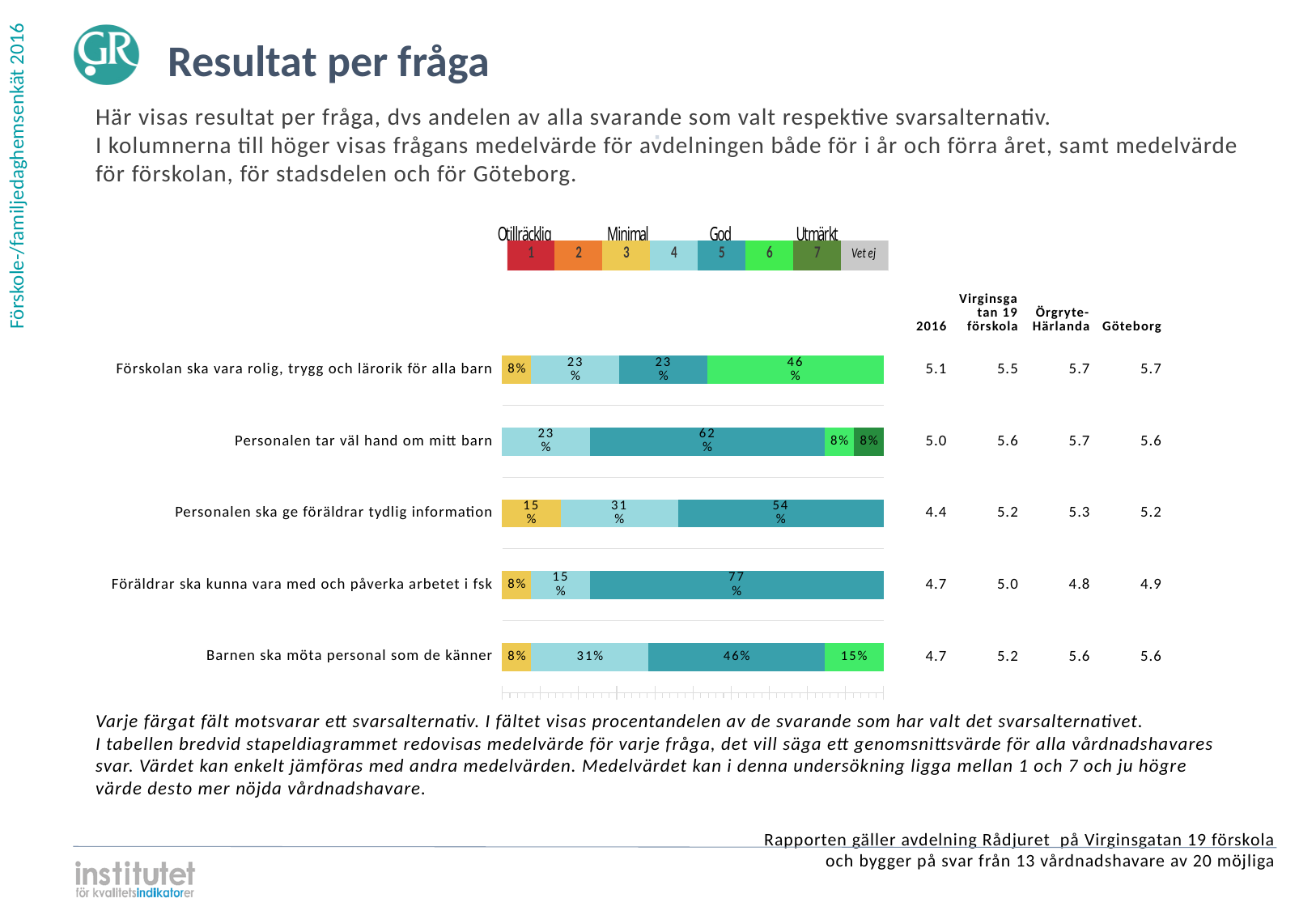
Which question has the largest single segment in the bar chart? Föräldrar ska kunna vara med och påverka arbetet i fsk What percentage of respondents chose alternative 6 (bright green) for 'Förskolan ska vara rolig, trygg och lärorik för alla barn'? 46% Which question is the only one with a segment for alternative 7 (dark green)? Personalen tar väl hand om mitt barn What kind of chart is shown on the slide? Stacked bar chart How many questions (categories) are plotted in the bar chart? 5 What percentage of respondents chose alternative 5 (teal) for 'Föräldrar ska kunna vara med och påverka arbetet i fsk'? 77% What is the difference between the alternative 5 share for 'Föräldrar ska kunna vara med och påverka arbetet i fsk' (77%) and for 'Personalen ska ge föräldrar tydlig information' (54%)? 23% Which is larger: the alternative 6 share for 'Förskolan ska vara rolig, trygg och lärorik för alla barn' or for 'Barnen ska möta personal som de känner'? Förskolan ska vara rolig, trygg och lärorik för alla barn What percentage of respondents chose alternative 4 (light blue) for 'Barnen ska möta personal som de känner'? 31% What percentage of respondents chose alternative 5 (teal) for 'Personalen tar väl hand om mitt barn'? 62% What percentage of respondents chose alternative 3 (yellow) for 'Personalen ska ge föräldrar tydlig information'? 15% How many answer alternatives does the legend above the chart list? 8